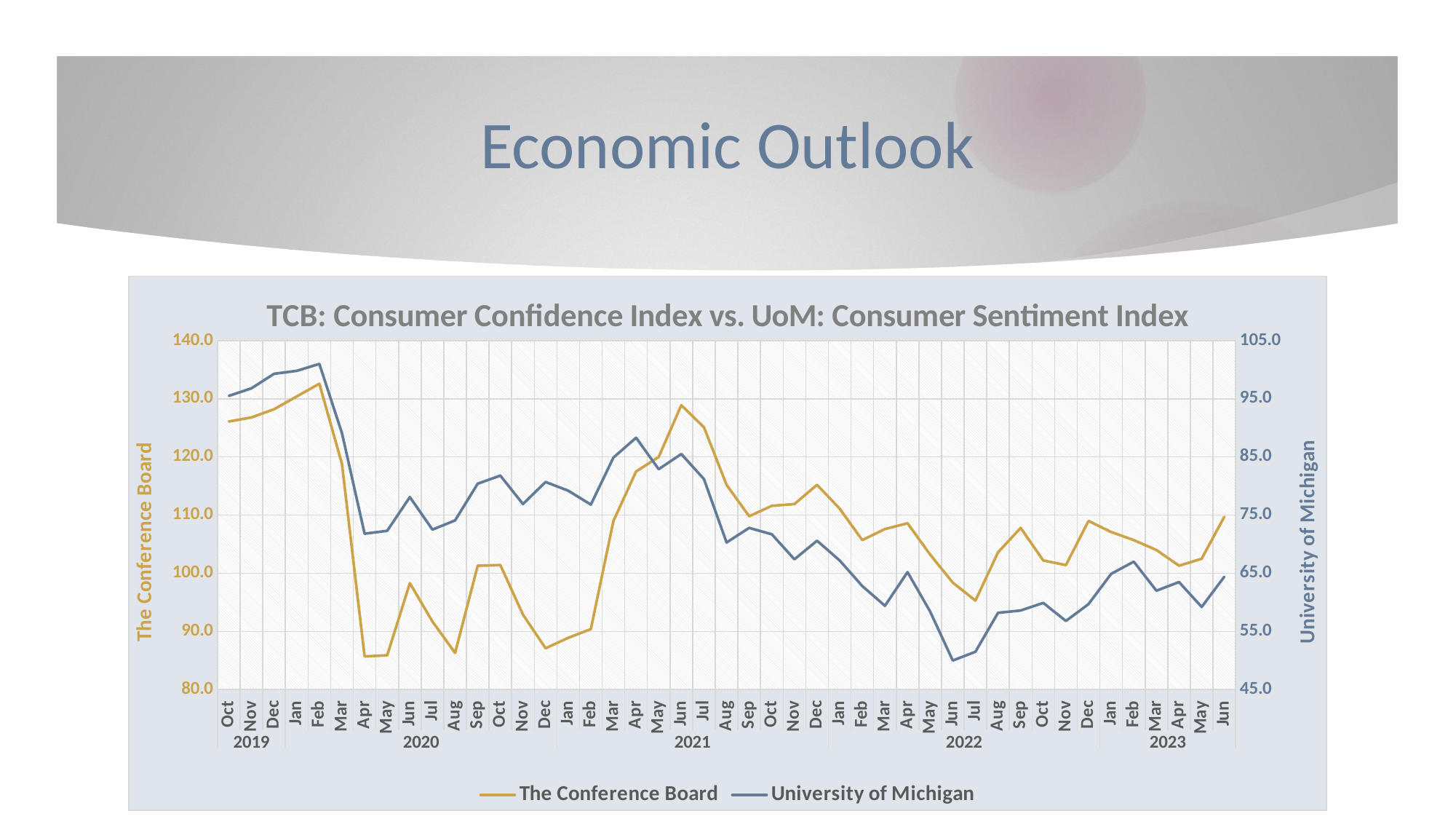
How many monthly data points are plotted for each series, from Oct 2019 to Jun 2023? 45 Is the value for University of Michigan in Feb 2020 greater or less than 95.0 on the right axis? greater In which month is The Conference Board series at its highest? Feb 2020 Which series is plotted against the left axis labelled 'The Conference Board'? The Conference Board In which month is the University of Michigan series at its lowest? Jun 2022 How many series does the legend list? 2 What is the title of the chart? TCB: Consumer Confidence Index vs. UoM: Consumer Sentiment Index Does the University of Michigan series rise or fall from Jun 2021 to Jun 2022? fall Is the value for The Conference Board in Apr 2020 greater or less than 90.0? less What kind of chart is shown on the slide? Line chart Is the value for University of Michigan in Jun 2022 greater or less than 55.0 on the right axis? less